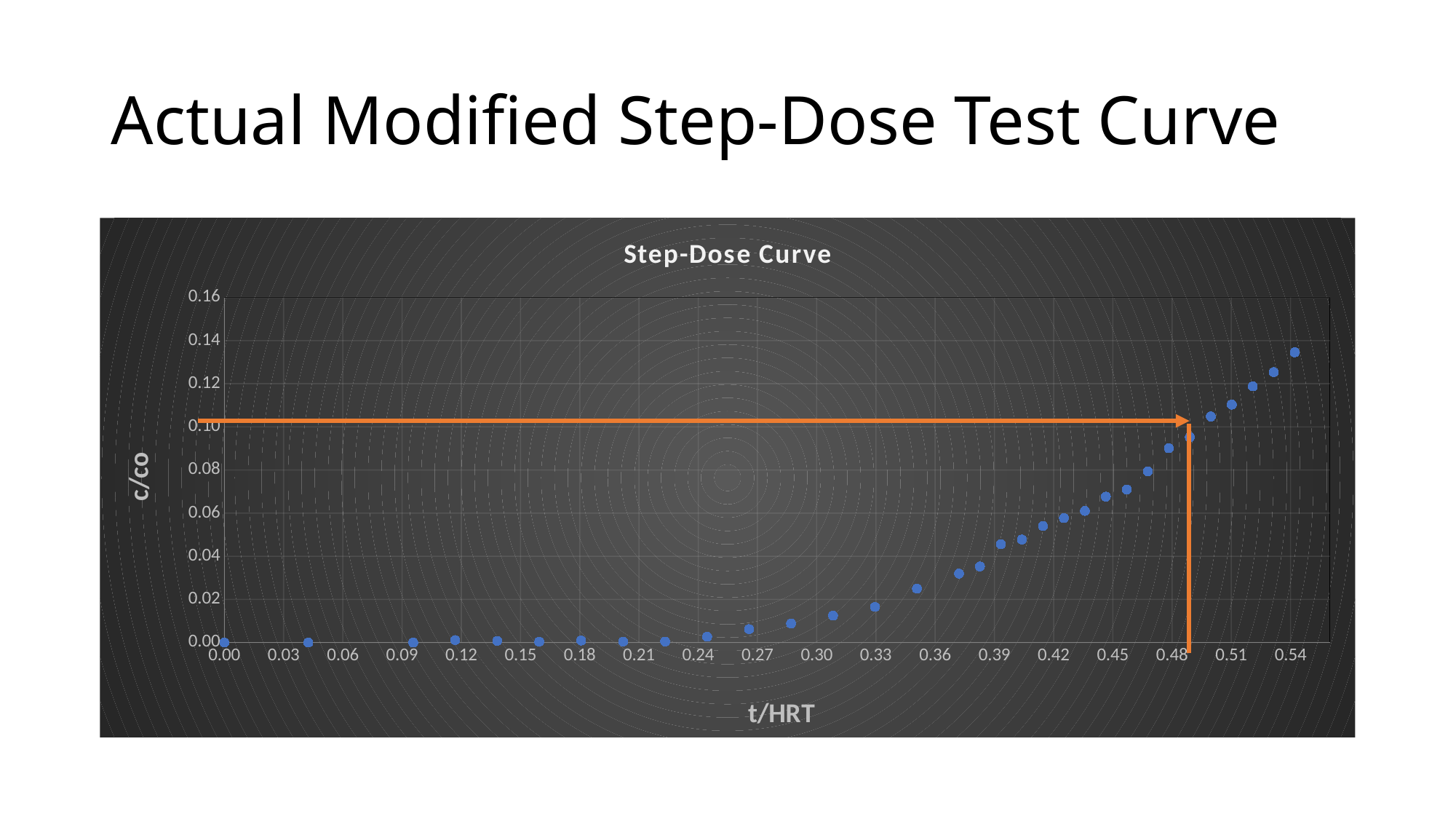
Do the c/co values rise or fall as t/HRT increases along the x axis? rise What is the highest tick value shown on the c/co axis? 0.16 Is the c/co value at t/HRT 0.45 greater or less than 0.08? less Is the c/co value at t/HRT 0.39 greater or less than 0.06? less What kind of chart is the Step-Dose Curve? scatter chart Which has the larger c/co value: the point at t/HRT 0.51 or the point at t/HRT 0.27? 0.51 What is the largest t/HRT tick label shown on the x axis? 0.54 What is the title of the chart on the slide? Step-Dose Curve What is the label on the vertical axis of the chart? c/co Is the c/co value at t/HRT 0.54 greater or less than 0.12? greater At which t/HRT value does the chart reach its highest c/co? 0.54